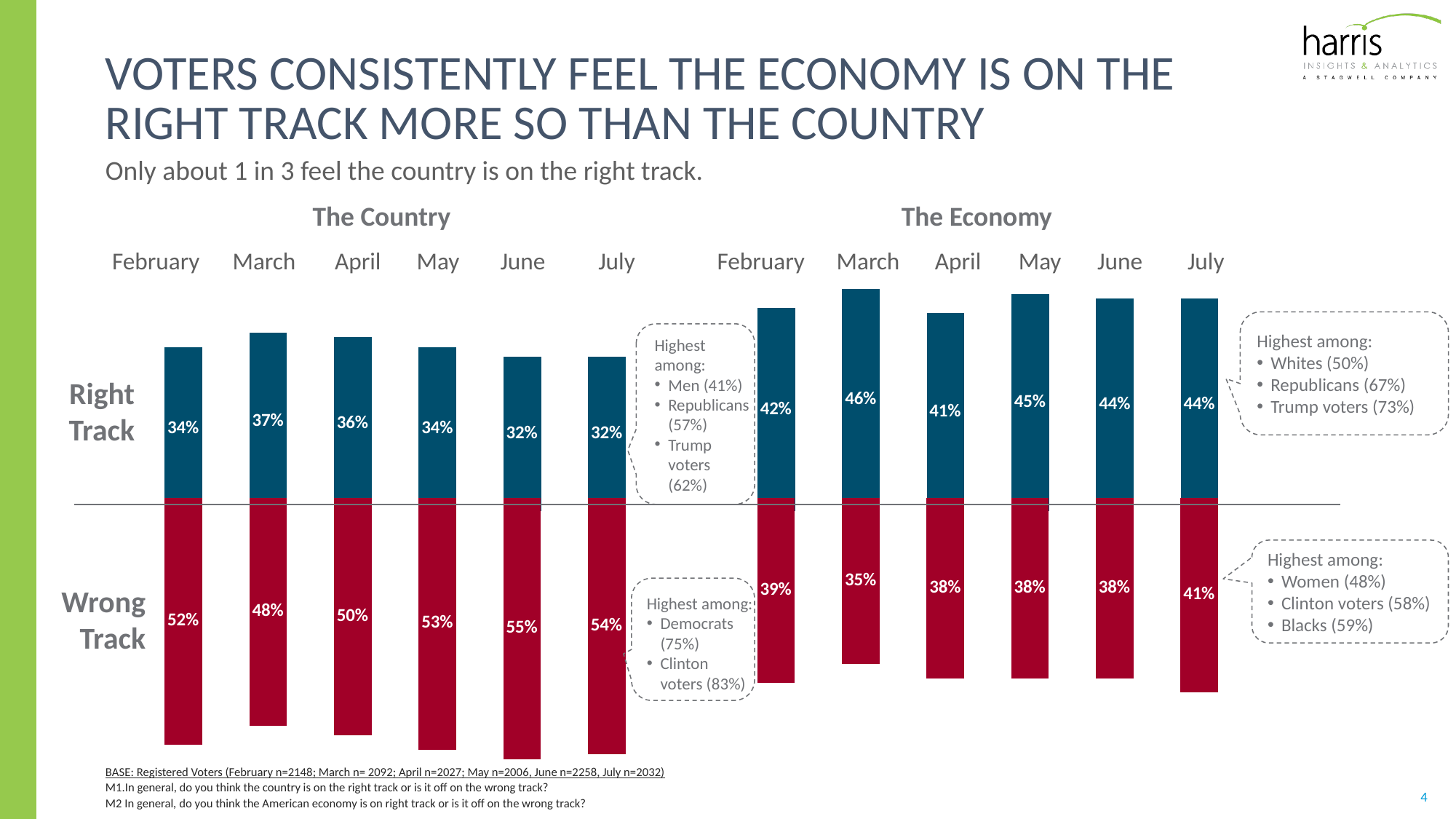
What colour are the Wrong Track bars in both charts? Red In The Country chart, what is the Wrong Track value for June? 55% How many months are shown in The Country chart? 6 In The Country chart, what is the Right Track value for March? 37% In The Country chart, which month has the lowest Wrong Track value? March In The Country chart, what is the difference between the Wrong Track and Right Track values for February? 18% In The Economy chart, which is larger for March: the Right Track value or the Wrong Track value? Right Track In The Economy chart, what is the Right Track value for May? 45% In The Economy chart, which month has the highest Right Track value? March In The Economy chart, what is the Wrong Track value for July? 41% In The Country chart, does the Right Track value rise or fall from April to June? Fall What type of chart is used for The Economy? Bar chart